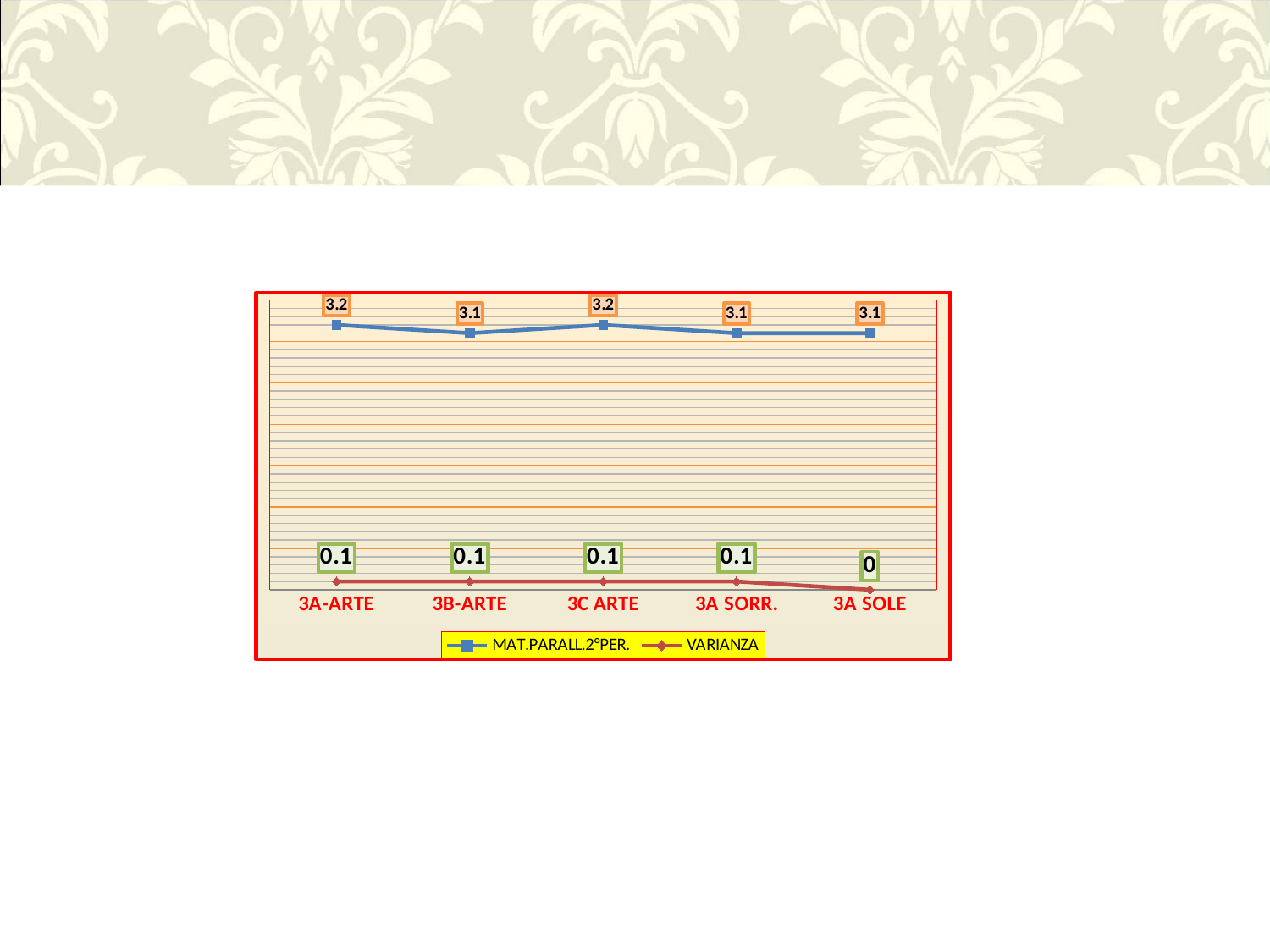
What is the value of MAT.PARALL.2°PER. for 3A SORR.? 3.1 What is the value of MAT.PARALL.2°PER. for 3B-ARTE? 3.1 Which category has the lowest VARIANZA value? 3A SOLE What are the two series names listed in the legend? MAT.PARALL.2°PER. and VARIANZA What is the value of MAT.PARALL.2°PER. for 3A-ARTE? 3.2 What is the difference between the MAT.PARALL.2°PER. values for 3C ARTE and 3A SOLE? 0.1 What kind of chart is shown on the slide? Line chart Which is larger, the MAT.PARALL.2°PER. value for 3A-ARTE or for 3B-ARTE? 3A-ARTE What is the value of VARIANZA for 3A SOLE? 0 How many series does the legend list? 2 What is the value of VARIANZA for 3C ARTE? 0.1 How many categories are shown on the x axis? 5